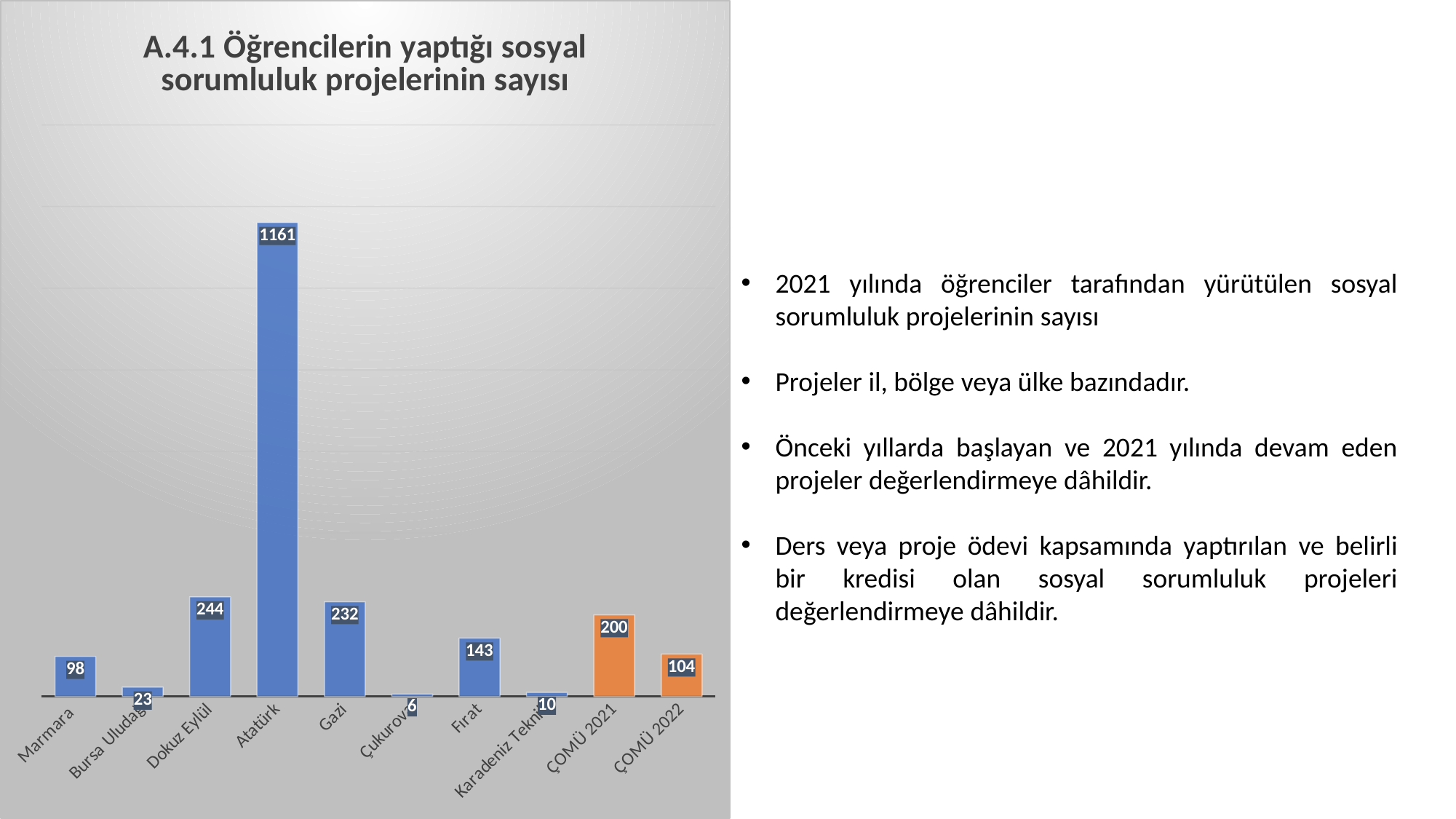
What is the difference between the values for Dokuz Eylül and Gazi? 12 Which category has the lowest value? Çukurova What colour are the bars for ÇOMÜ 2021 and ÇOMÜ 2022? Orange What is the value for ÇOMÜ 2021? 200 How many categories are shown on the x axis? 10 Which category has the highest value? Atatürk What is the difference between the values for ÇOMÜ 2021 and ÇOMÜ 2022? 96 What is the value for Karadeniz Teknik? 10 What is the value for Bursa Uludağ? 23 What kind of chart is shown on the slide? Bar chart Which is larger, the value for Marmara or the value for Fırat? Fırat What is the value for Atatürk? 1161